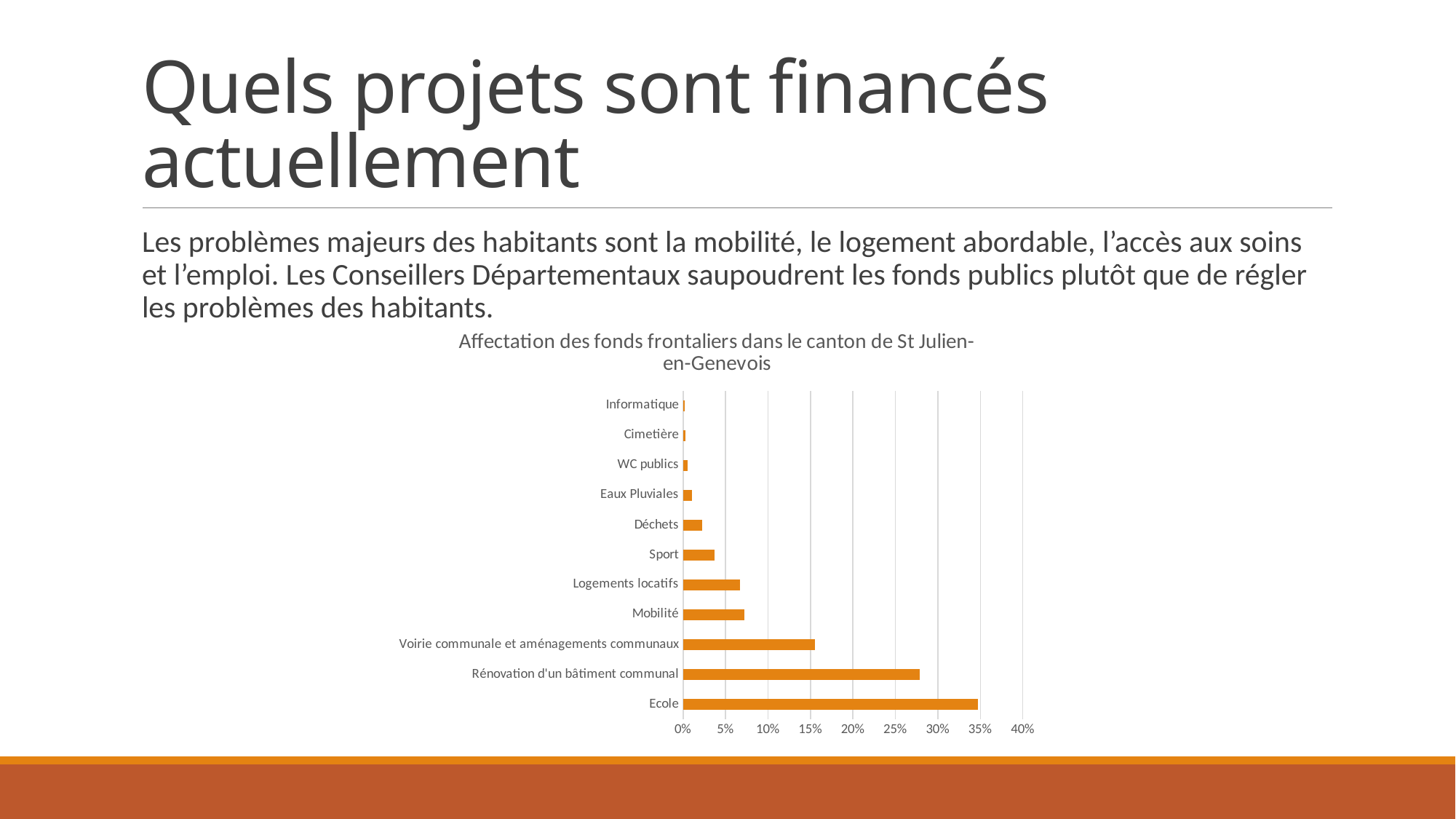
Is the value for Mobilité greater or less than 5%? greater Is the value for Sport greater or less than 5%? less Is the value for Rénovation d'un bâtiment communal greater or less than 25%? greater How many categories are plotted in the chart? 11 Which is larger, the value for Ecole or the value for Rénovation d'un bâtiment communal? Ecole What is the title of the chart? Affectation des fonds frontaliers dans le canton de St Julien-en-Genevois Which category has the highest value in the chart? Ecole Which is larger, the value for Voirie communale et aménagements communaux or the value for Mobilité? Voirie communale et aménagements communaux What kind of chart is shown on the slide? bar chart